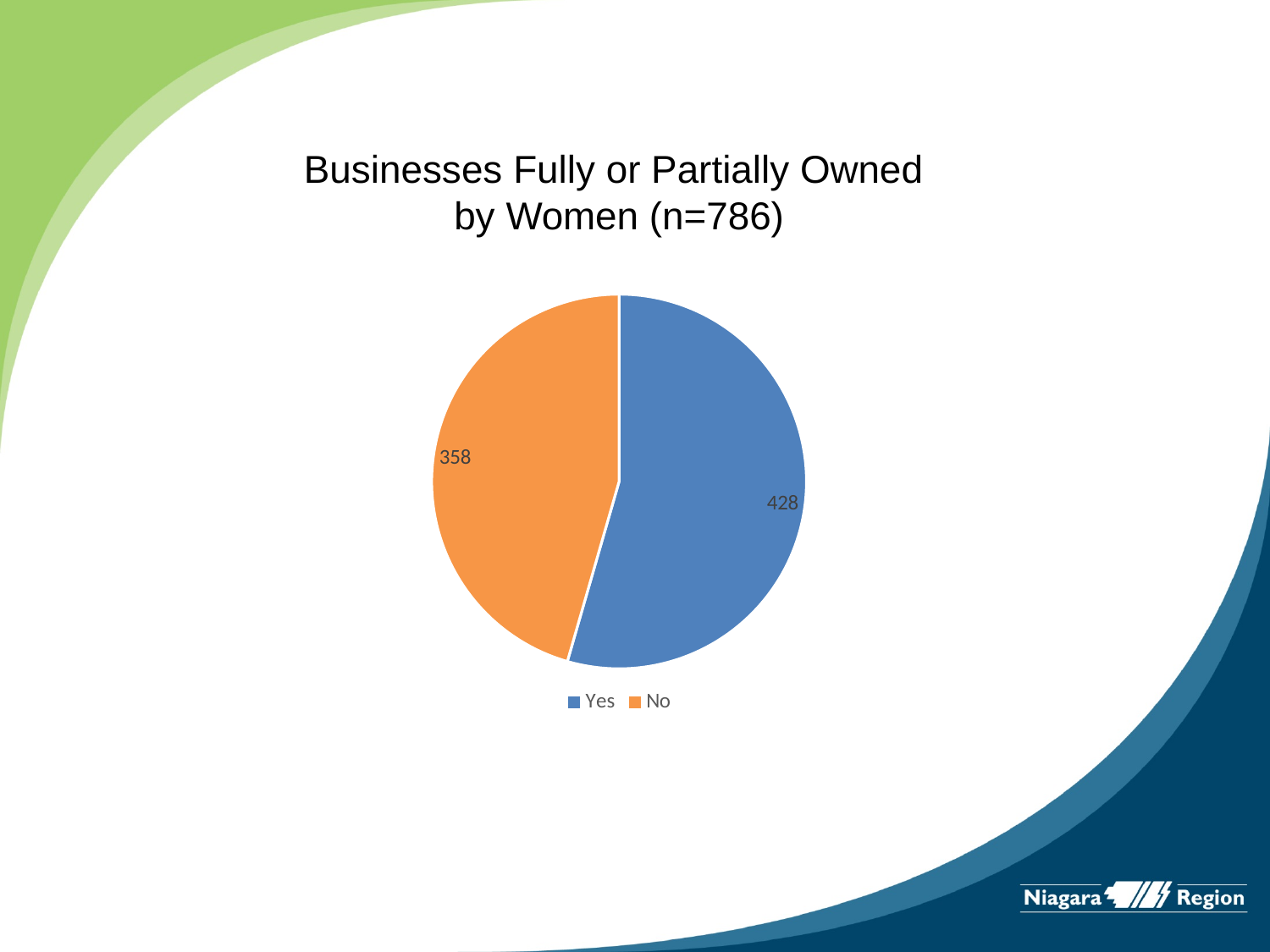
How many categories does the pie chart have? 2 Which category has the larger slice, Yes or No? Yes How many businesses answered Yes to being fully or partially owned by women? 428 How many businesses answered No to being fully or partially owned by women? 358 What is the difference between the number of Yes responses and No responses? 70 Which category has the smallest slice in the pie chart? No What colour is the Yes slice in the pie chart? Blue What type of chart is shown on the slide? Pie chart What is the total of the two slices in the pie chart? 786 Which category has the largest slice in the pie chart? Yes What is the title of the chart? Businesses Fully or Partially Owned by Women (n=786) How many entries does the legend list? 2